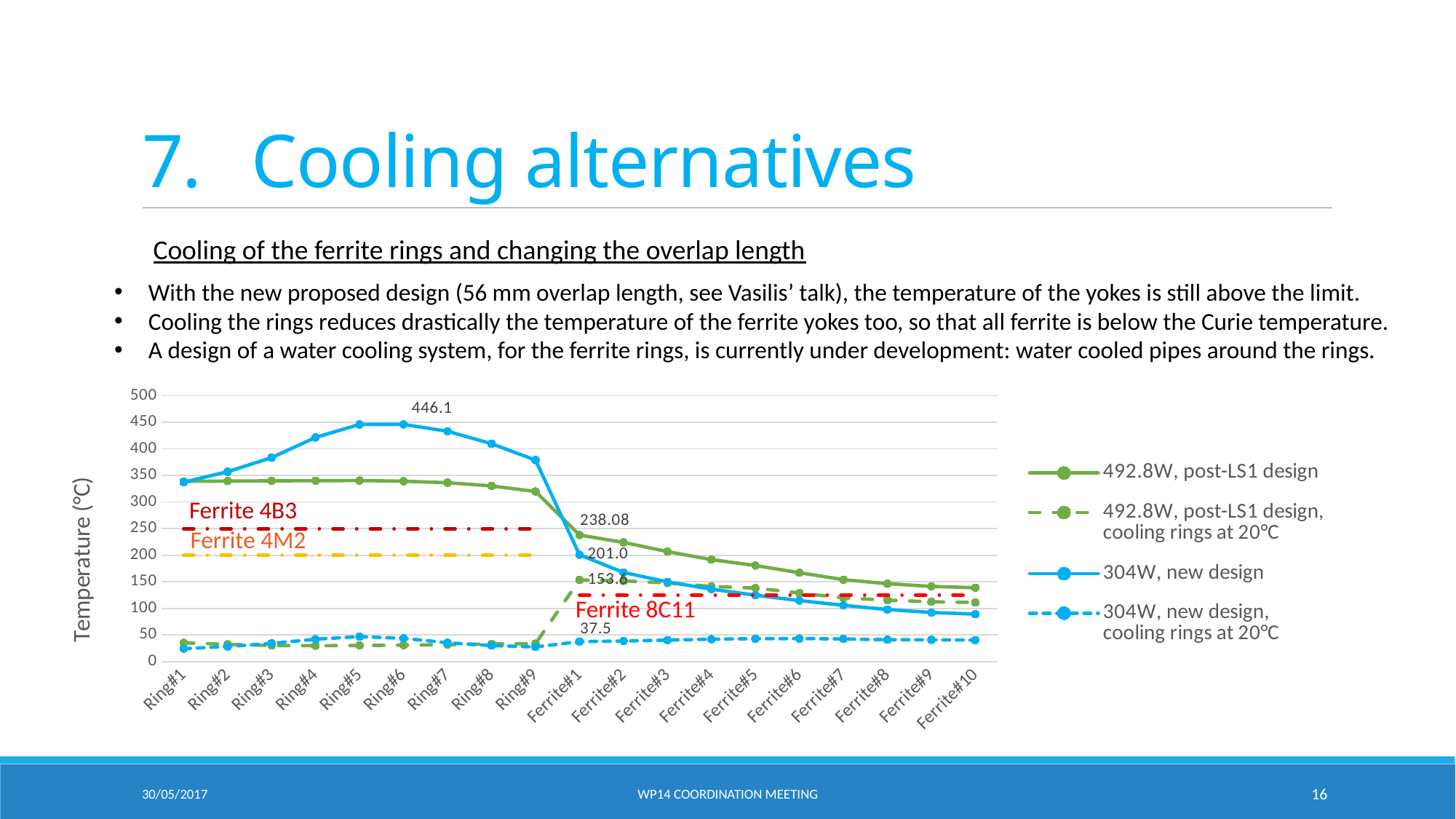
What is the value of the 492.8W, post-LS1 design, cooling rings at 20°C series at Ferrite#1? 153.6 What is the value of the 304W, new design, cooling rings at 20°C series at Ferrite#1? 37.5 How many categories are shown along the x axis? 19 What kind of chart is shown on the slide? line chart At Ferrite#1, which is larger: the 492.8W, post-LS1 design value or the 304W, new design value? 492.8W, post-LS1 design Is the value of the 304W, new design series at Ring#5 greater or less than 400? greater What is the difference between the 492.8W, post-LS1 design value and the 304W, new design value at Ferrite#1? 37.08 Which series reaches the highest labelled value, 446.1? 304W, new design Does the 304W, new design series rise or fall from Ferrite#1 to Ferrite#10? fall How many series does the legend list? 4 What is the value of the 304W, new design series at Ferrite#1? 201.0 What is the value of the 492.8W, post-LS1 design series at Ferrite#1? 238.08